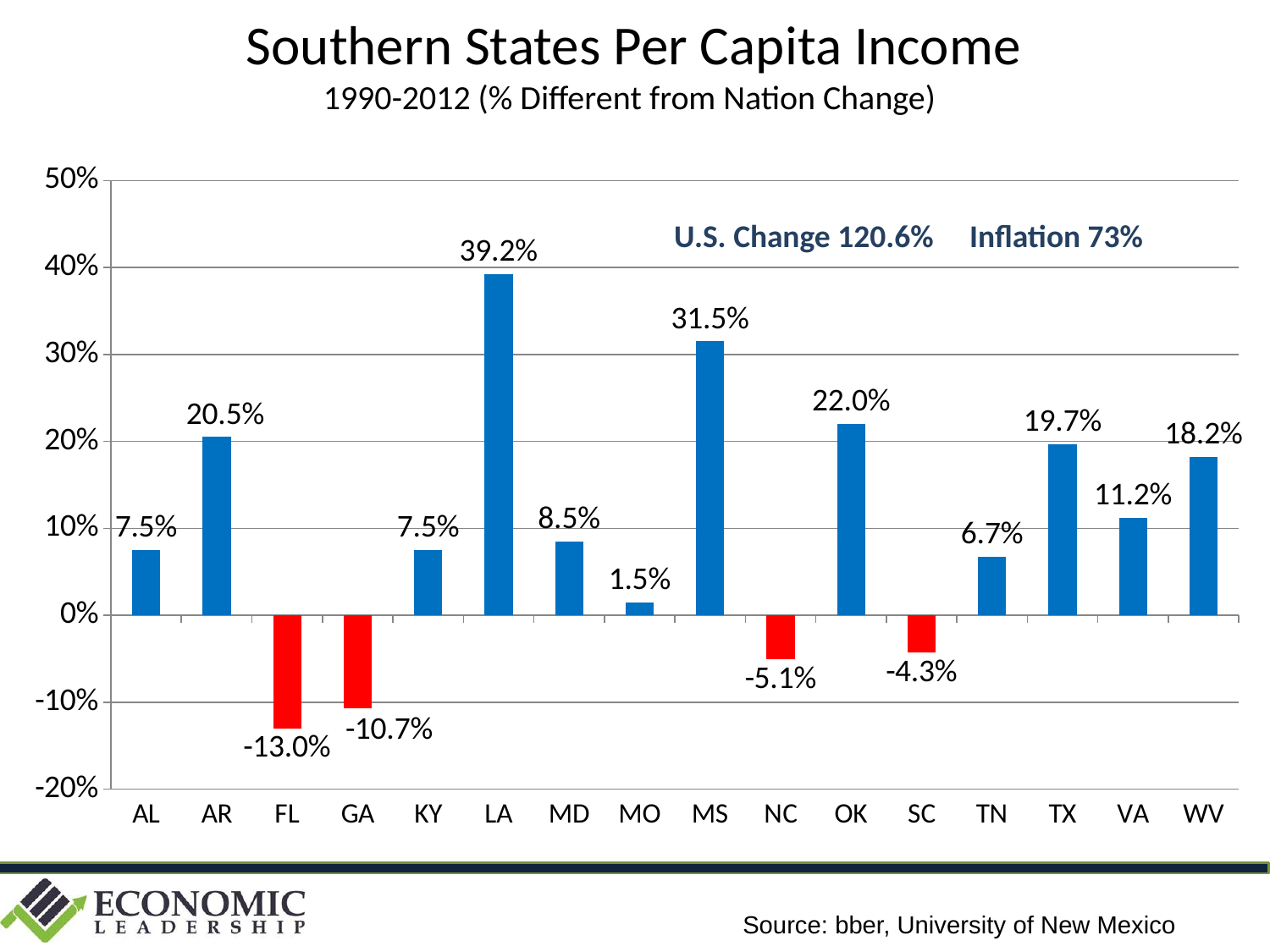
What kind of chart is this? Bar chart Which state has the lowest value? FL Which state has the highest value? LA How many states have negative values? 4 What is the title of the chart? Southern States Per Capita Income What is the difference between the values for MS and OK? 9.5% How many states are shown on the x axis? 16 What is the value for LA? 39.2% What is the value for TN? 6.7% What is the value for FL? -13.0% What U.S. Change figure is printed on the chart? 120.6% Which is larger, the value for TX or the value for WV? TX